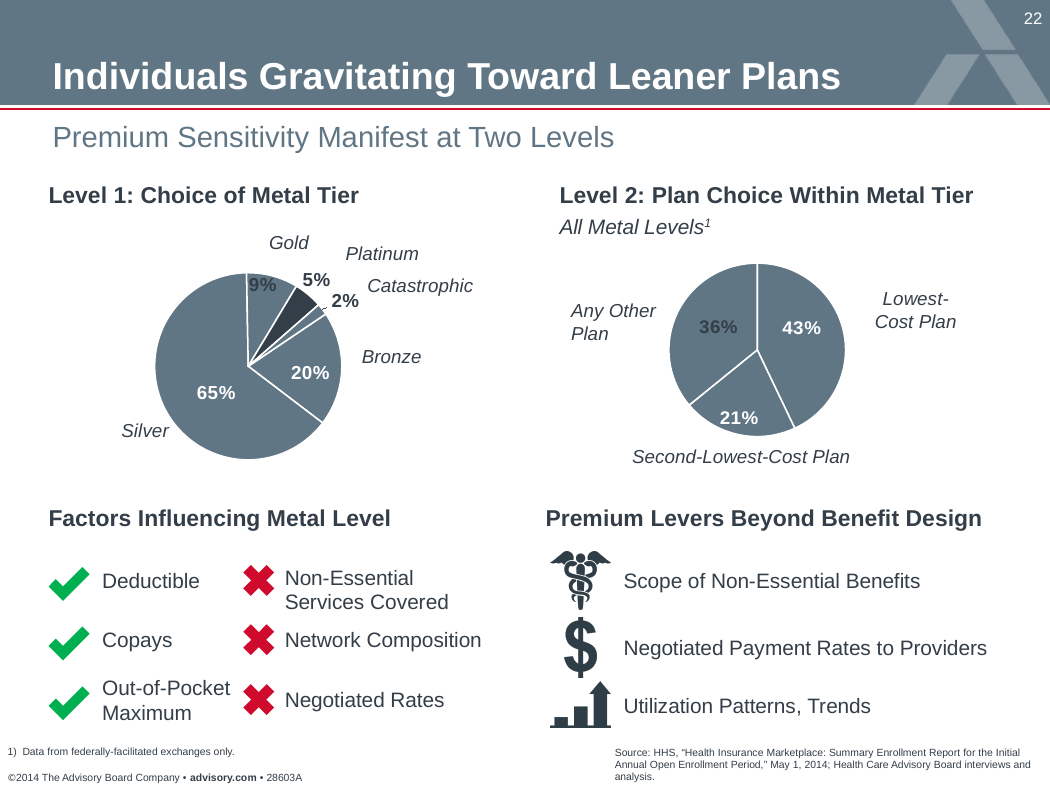
In the 'Level 1: Choice of Metal Tier' chart, what share of the pie is Bronze? 20% In the 'Level 1: Choice of Metal Tier' chart, how many metal tiers are shown? 5 What kind of chart is used for 'Level 2: Plan Choice Within Metal Tier'? Pie chart In the 'Level 2: Plan Choice Within Metal Tier' chart, what share is the Lowest-Cost Plan? 43% In the 'Level 2: Plan Choice Within Metal Tier' chart, what is the difference between the Any Other Plan and Second-Lowest-Cost Plan shares? 15% In the 'Level 2: Plan Choice Within Metal Tier' chart, which is larger: Any Other Plan or Lowest-Cost Plan? Lowest-Cost Plan In the 'Level 1: Choice of Metal Tier' chart, what share of the pie is Catastrophic? 2% In the 'Level 1: Choice of Metal Tier' chart, what share of the pie is Silver? 65% In the 'Level 1: Choice of Metal Tier' chart, what is the difference between the Gold and Platinum shares? 4% In the 'Level 2: Plan Choice Within Metal Tier' chart, what share is the Second-Lowest-Cost Plan? 21% In the 'Level 1: Choice of Metal Tier' chart, which metal tier has the smallest share? Catastrophic In the 'Level 1: Choice of Metal Tier' chart, which metal tier has the largest share? Silver